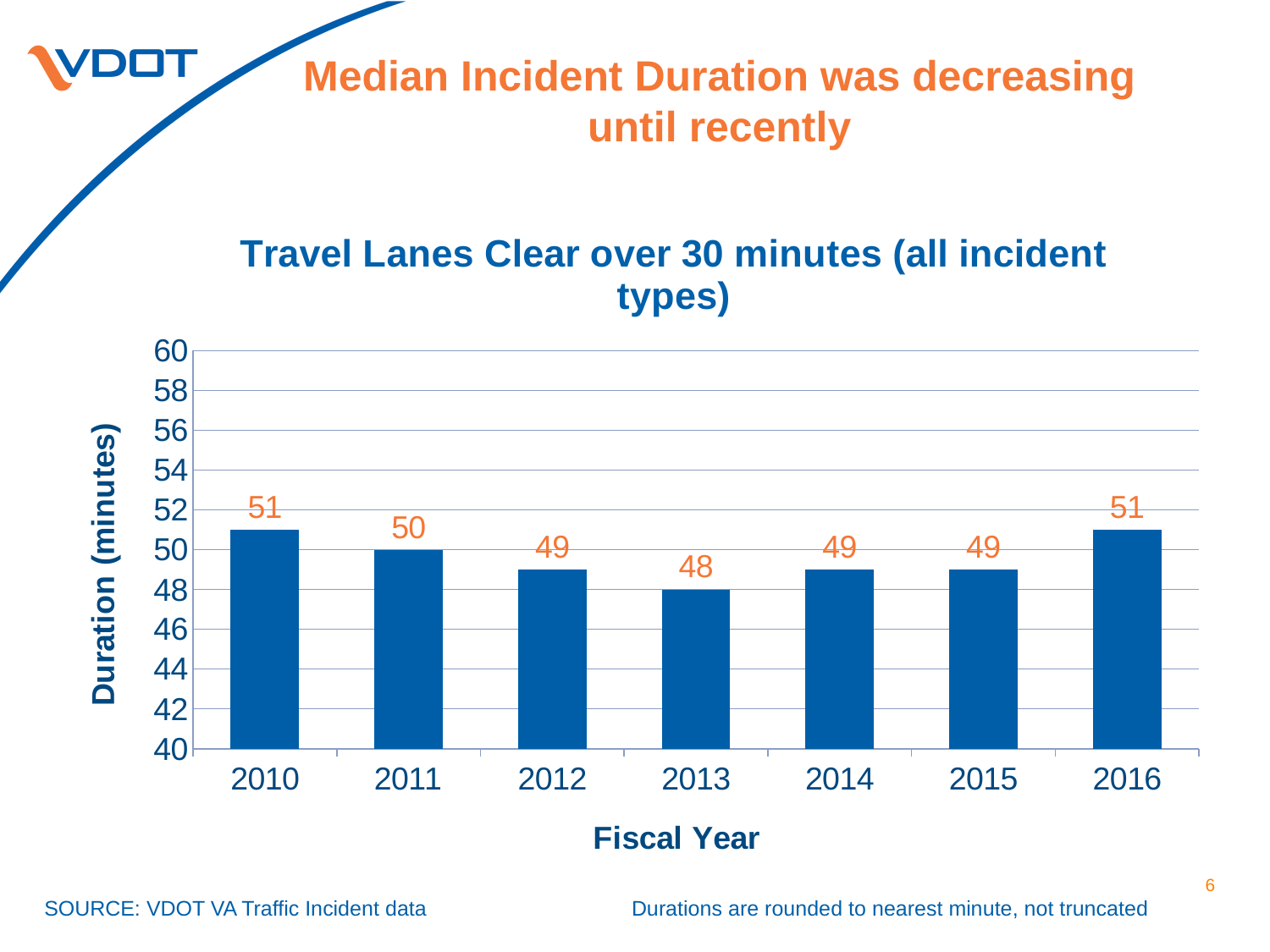
What is the median incident duration for fiscal year 2013? 48 Which has a larger median incident duration, fiscal year 2011 or fiscal year 2014? 2011 What is the difference in duration between fiscal year 2010 and fiscal year 2013? 3 What is the median incident duration for fiscal year 2011? 50 What is the median incident duration for fiscal year 2016? 51 How many fiscal years are shown on the x axis? 7 What is the difference in duration between fiscal year 2016 and fiscal year 2015? 2 What kind of chart is shown on the slide? bar chart Is the value for fiscal year 2013 greater or less than 50? less Which fiscal year has the lowest median incident duration? 2013 What is the label of the y axis? Duration (minutes) Do the values rise or fall from fiscal year 2010 to fiscal year 2013? fall